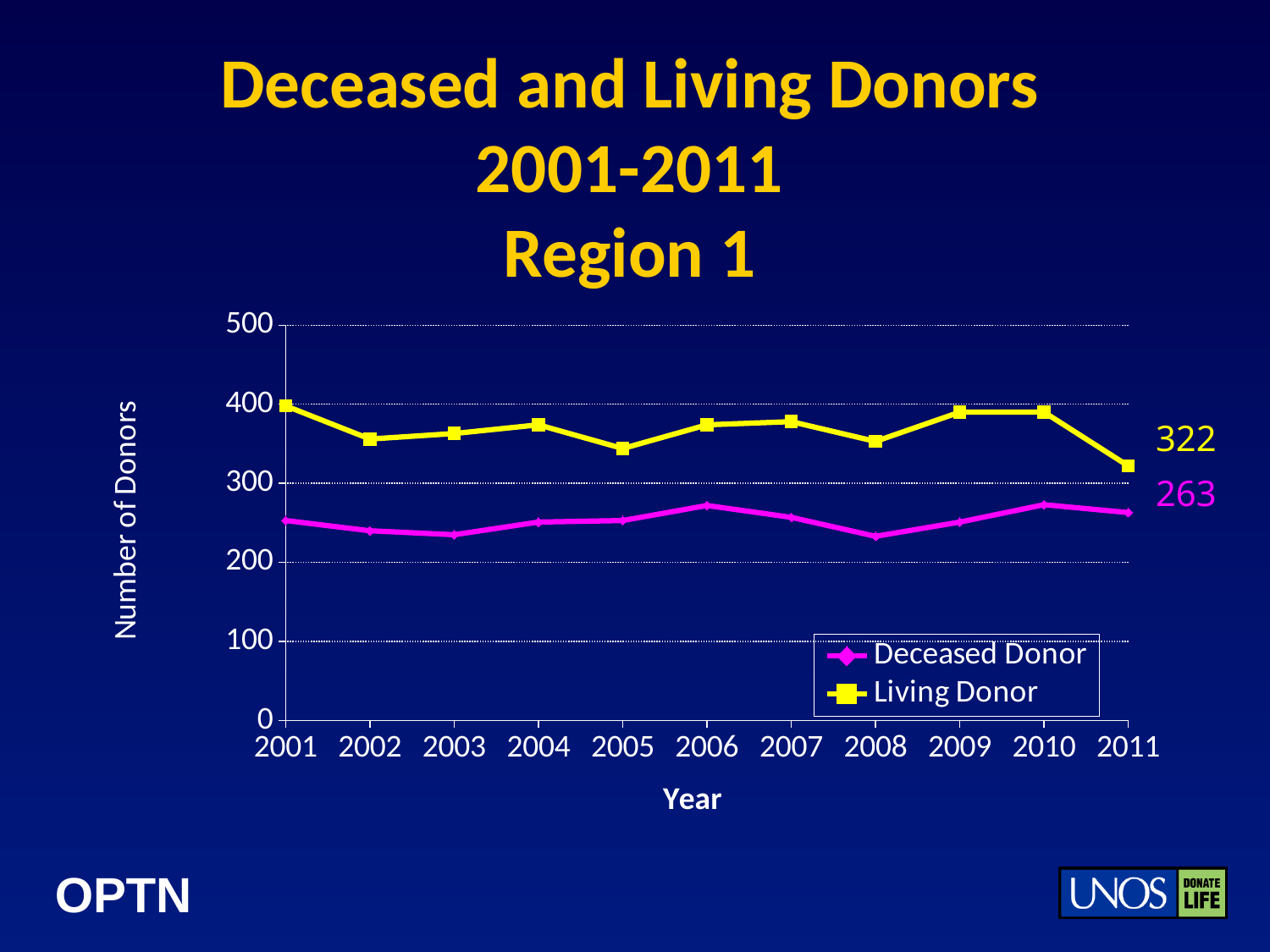
Is the value for Living Donor in 2001 greater or less than 300? greater What kind of chart is shown on the slide? line chart In 2011, which series has the larger value, Living Donor or Deceased Donor? Living Donor How many years are shown on the x axis? 11 What is the value for Deceased Donor in 2011? 263 Does the Living Donor line rise or fall from 2010 to 2011? fall What is the difference between the Living Donor and Deceased Donor values in 2011? 59 In which year is the Living Donor value lowest? 2011 Which colour is used for the Living Donor series? yellow Is the value for Deceased Donor in 2008 greater or less than 300? less How many series does the legend list? 2 What is the value for Living Donor in 2011? 322